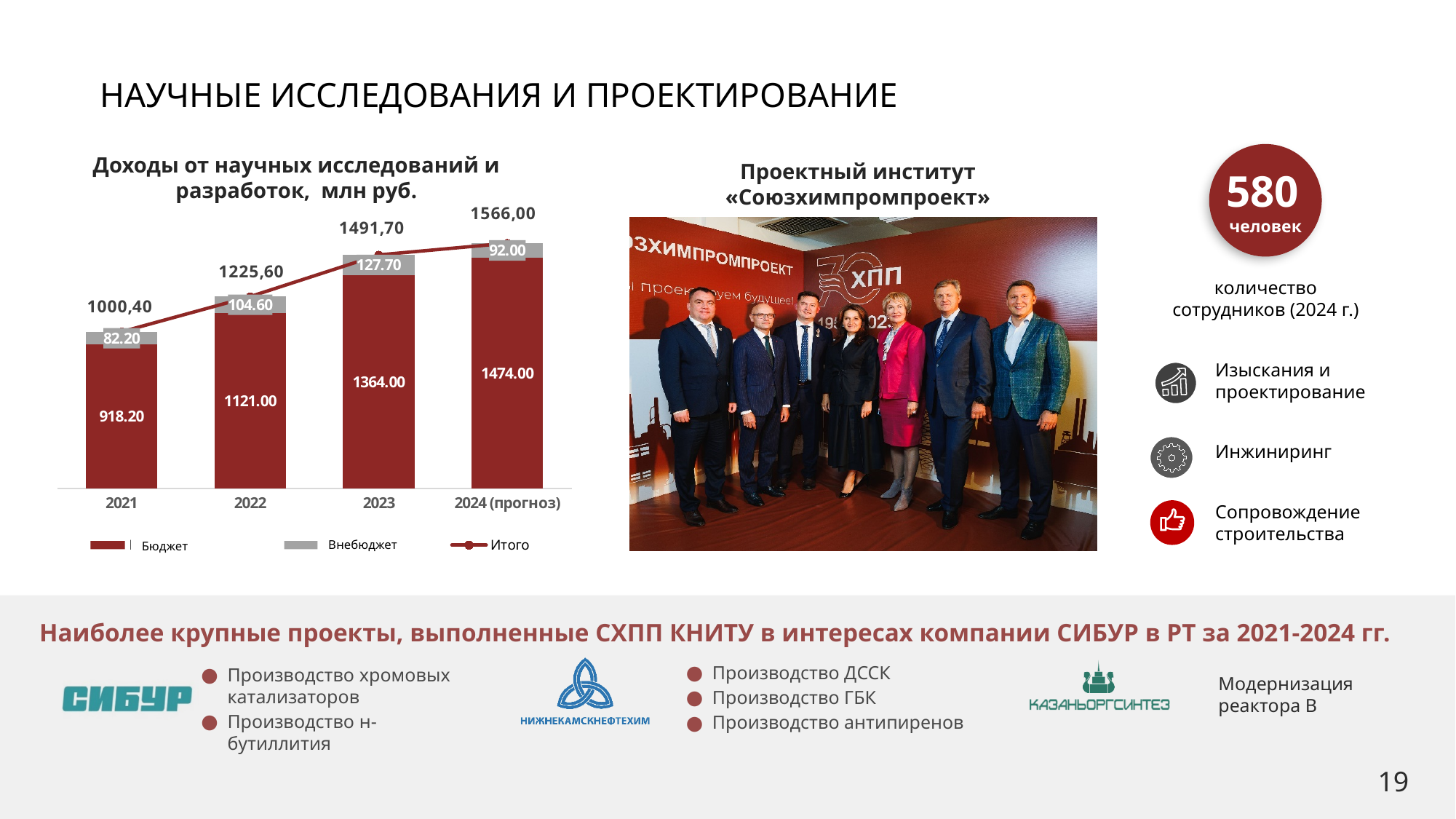
What is the difference between the Бюджет values for 2023 and 2022? 243.00 What is the Бюджет value for 2021 in the chart 'Доходы от научных исследований и разработок, млн руб.'? 918.20 What kind of chart is used to show the income from research and development? Stacked bar chart with a line Does the Итого line rise or fall from 2021 to 2024 (прогноз)? Rises What is the Итого value for 2024 (прогноз)? 1566,00 What is the Внебюджет value for 2022? 104.60 What is the Внебюджет value for 2023? 127.70 How many series does the chart legend list? 3 Which year has the lowest Внебюджет value? 2021 Which year has the highest Бюджет value? 2024 (прогноз) Which is larger, the Внебюджет value for 2023 or for 2024 (прогноз)? 2023 How many years are shown on the x axis of the chart? 4